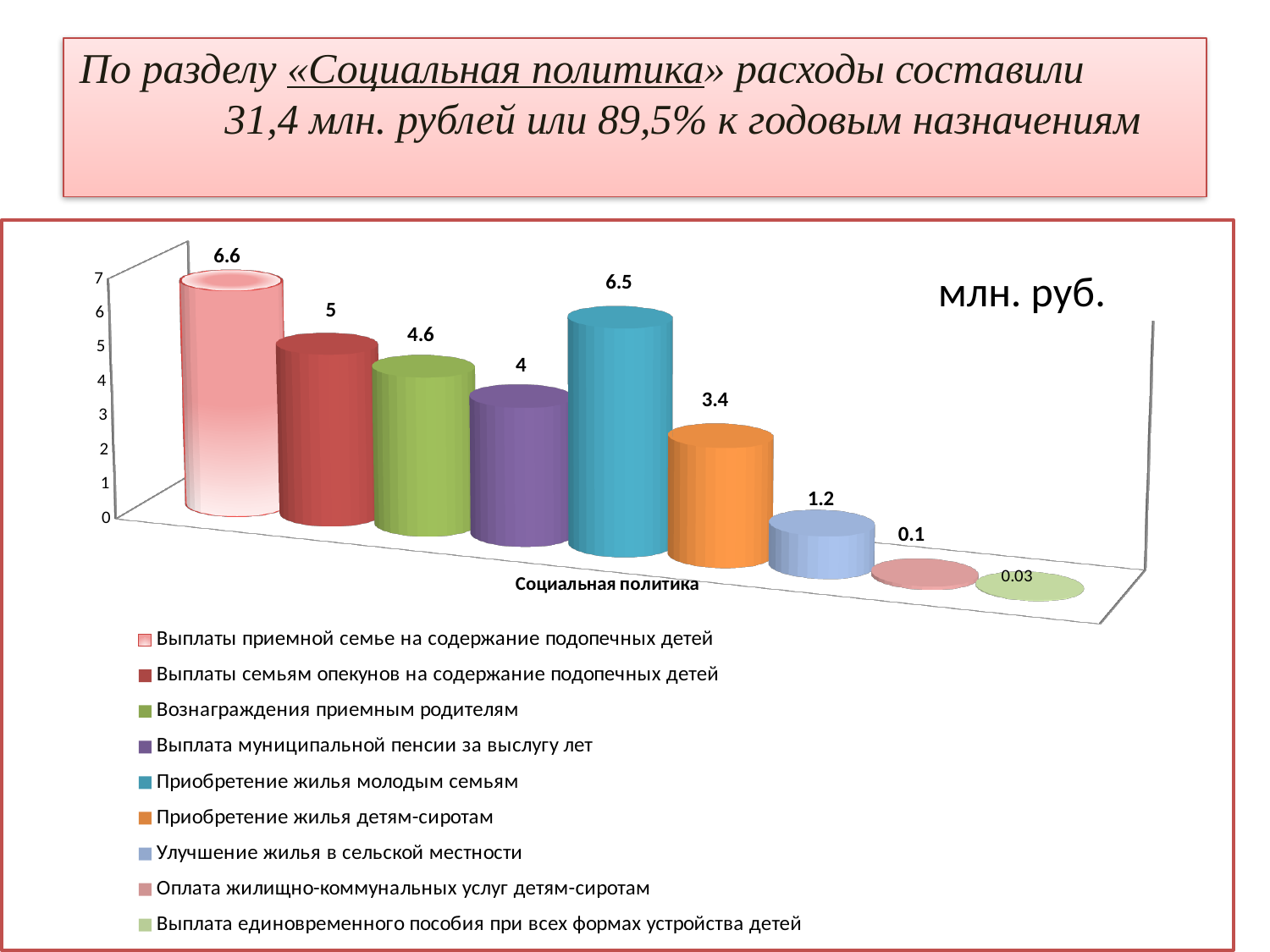
What unit is indicated on the chart? млн. руб. What is the category label shown on the x axis? Социальная политика How many series does the legend list? 9 What is the value for «Приобретение жилья молодым семьям»? 6.5 What kind of chart is shown on the slide? Bar chart What is the difference between «Приобретение жилья детям-сиротам» and «Улучшение жилья в сельской местности»? 2.2 Which is larger: «Выплаты семьям опекунов на содержание подопечных детей» or «Приобретение жилья детям-сиротам»? Выплаты семьям опекунов на содержание подопечных детей Which series has the lowest value? Выплата единовременного пособия при всех формах устройства детей What is the value for «Улучшение жилья в сельской местности»? 1.2 What is the value for «Выплаты приемной семье на содержание подопечных детей»? 6.6 What is the difference between «Выплаты семьям опекунов на содержание подопечных детей» and «Вознаграждения приемным родителям»? 0.4 What is the value for «Выплата муниципальной пенсии за выслугу лет»? 4